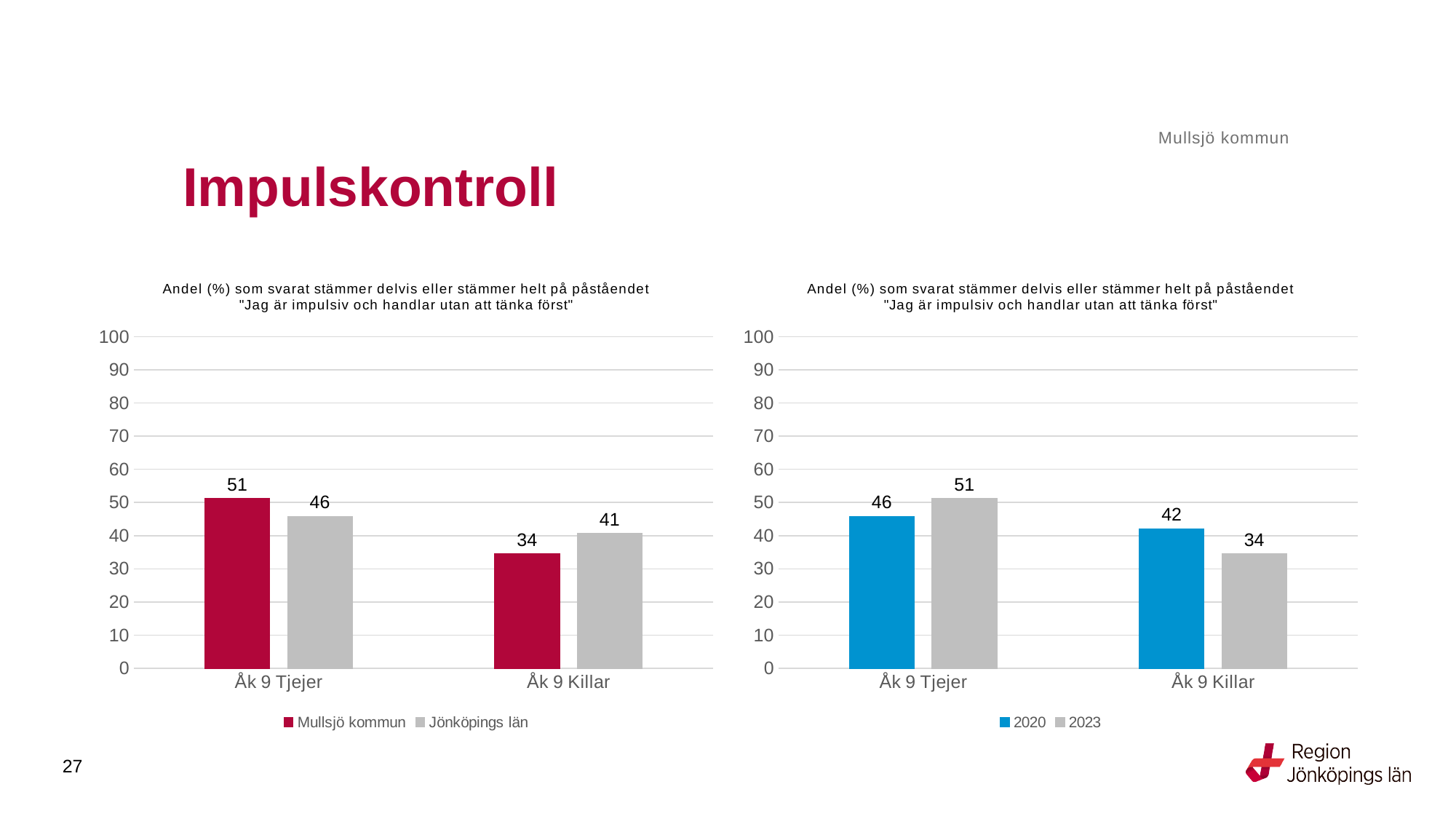
In the right chart, what is the value for 2020 for Åk 9 Killar? 42 In the right chart, which category has the lowest value across both series? Åk 9 Killar (2023) In the right chart, what is the difference between 2020 and 2023 for Åk 9 Killar? 8 In the right chart, what is the value for 2023 for Åk 9 Tjejer? 51 In the left chart, what is the value for Jönköpings län for Åk 9 Killar? 41 In the left chart, what is the difference between Mullsjö kommun and Jönköpings län for Åk 9 Killar? 7 In the left chart, what is the value for Mullsjö kommun for Åk 9 Tjejer? 51 How many series does the legend of the left chart list? 2 In the left chart, which is larger for Åk 9 Tjejer: Mullsjö kommun or Jönköpings län? Mullsjö kommun What kind of chart is the right chart? Bar chart In the right chart, which year has the higher value for Åk 9 Killar? 2020 What are the two series listed in the legend of the right chart? 2020 and 2023